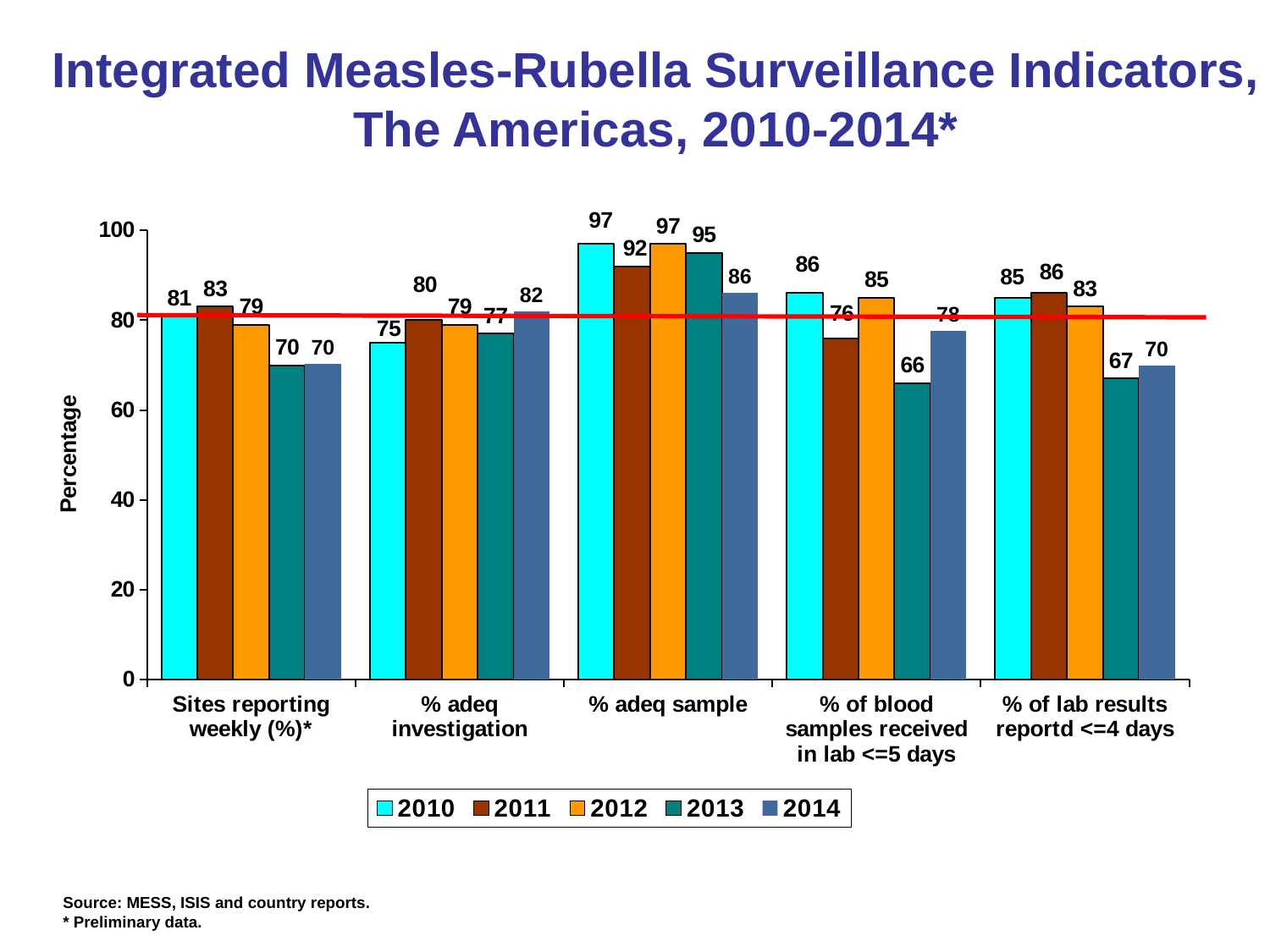
Do the values for 'Sites reporting weekly (%)*' rise or fall from 2010 to 2014? fall How many series does the legend list? 5 What is the label of the y axis? Percentage What is the value for 2011 in the '% of lab results reportd <=4 days' category? 86 What is the value for 2014 in the '% adeq investigation' category? 82 What is the difference between the 2010 and 2013 values in the '% of lab results reportd <=4 days' category? 18 How many categories are shown on the x axis? 5 Which is larger in the '% adeq sample' category: the 2011 value or the 2013 value? 2013 Which year has the lowest value in the '% adeq sample' category? 2014 What kind of chart is shown on the slide? bar chart What is the value for 2013 in the '% of blood samples received in lab <=5 days' category? 66 Which year has the highest value in the 'Sites reporting weekly (%)*' category? 2011